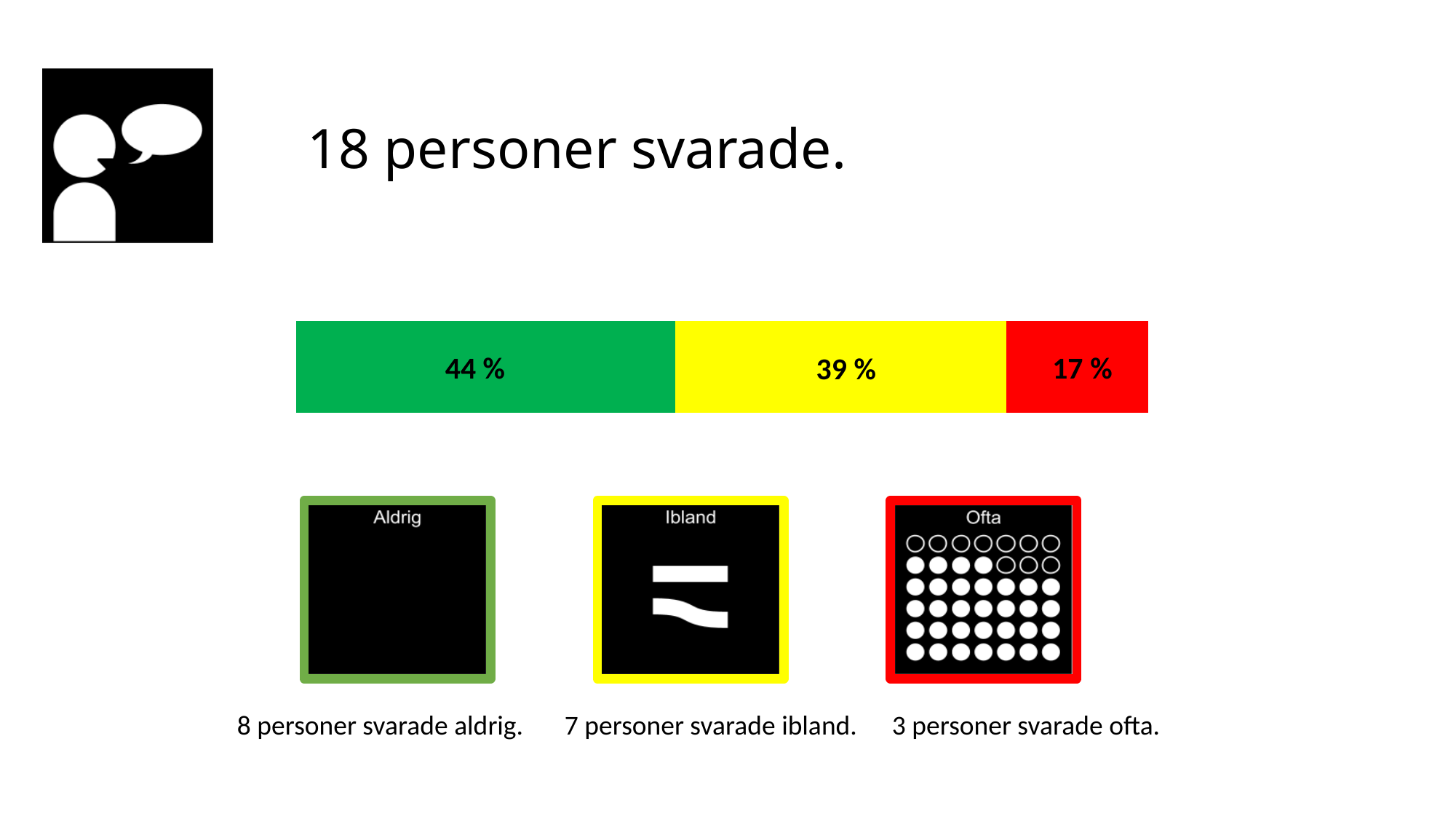
How many segments does the bar have? 3 What percentage is shown in the green segment of the bar? 44 % Which segment of the bar has the largest percentage? The green segment (44 %) What is the total of the three percentages shown in the bar? 100 % What is the difference in percentage points between the green segment and the yellow segment? 5 What percentage is shown in the yellow segment of the bar? 39 % What is the difference in percentage points between the green segment and the red segment? 27 What percentage is shown in the red segment of the bar? 17 % Which is larger, the yellow segment or the red segment? The yellow segment According to the slide, how many people answered in total? 18 What kind of chart is shown on the slide? A stacked bar chart Which segment of the bar has the smallest percentage? The red segment (17 %)